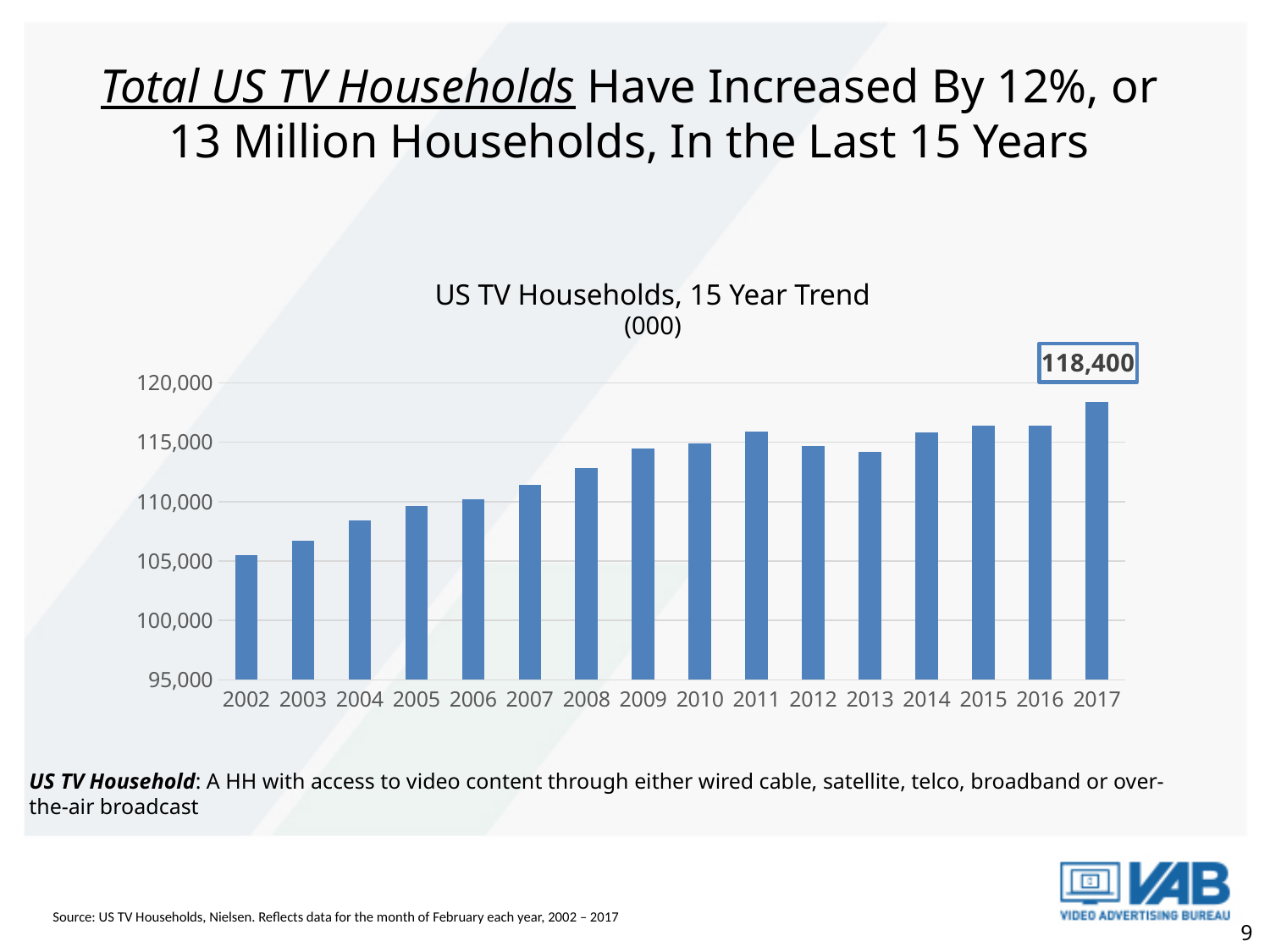
Which year has the highest number of US TV households in the chart? 2017 Do the values in the chart generally rise or fall from 2002 to 2017? Rise How many years (bars) are plotted in the chart? 16 Is the value for 2008 greater or less than 110,000? greater Which year has the larger value, 2007 or 2008? 2008 What is the value shown for 2017 in the US TV Households chart? 118,400 What is the title of the chart on the slide? US TV Households, 15 Year Trend (000) Is the value for 2002 greater or less than 110,000? less Which year has the lowest number of US TV households in the chart? 2002 What kind of chart is used to show the US TV Households trend? Bar chart Is the value for 2010 greater or less than 110,000? greater Which year has the larger value, 2009 or 2002? 2009